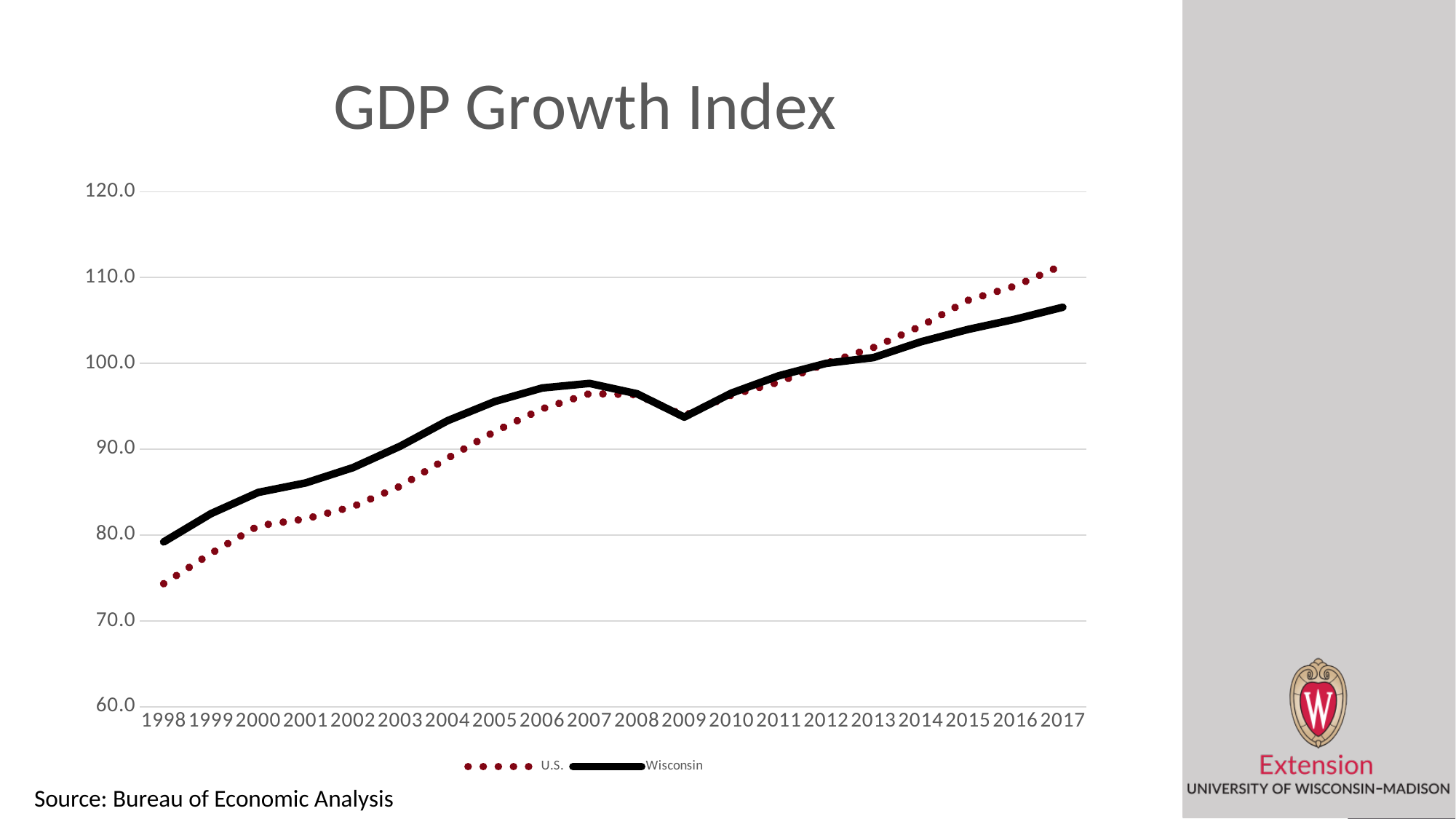
Do the values for the U.S. series generally rise or fall from 1998 to 2017? rise In 1998, which series has the higher value, U.S. or Wisconsin? Wisconsin In which year is the U.S. series at its lowest? 1998 In 2017, which series has the higher value, U.S. or Wisconsin? U.S. What is the title of the chart? GDP Growth Index How many years are shown on the x axis? 20 Which series is drawn with a dotted line? U.S. Is the value for U.S. in 1998 greater or less than 80.0? less In which year is the Wisconsin series at its highest? 2017 How many series does the legend list? 2 Is the value for Wisconsin in 2009 greater or less than 100.0? less What kind of chart is shown on the slide? line chart